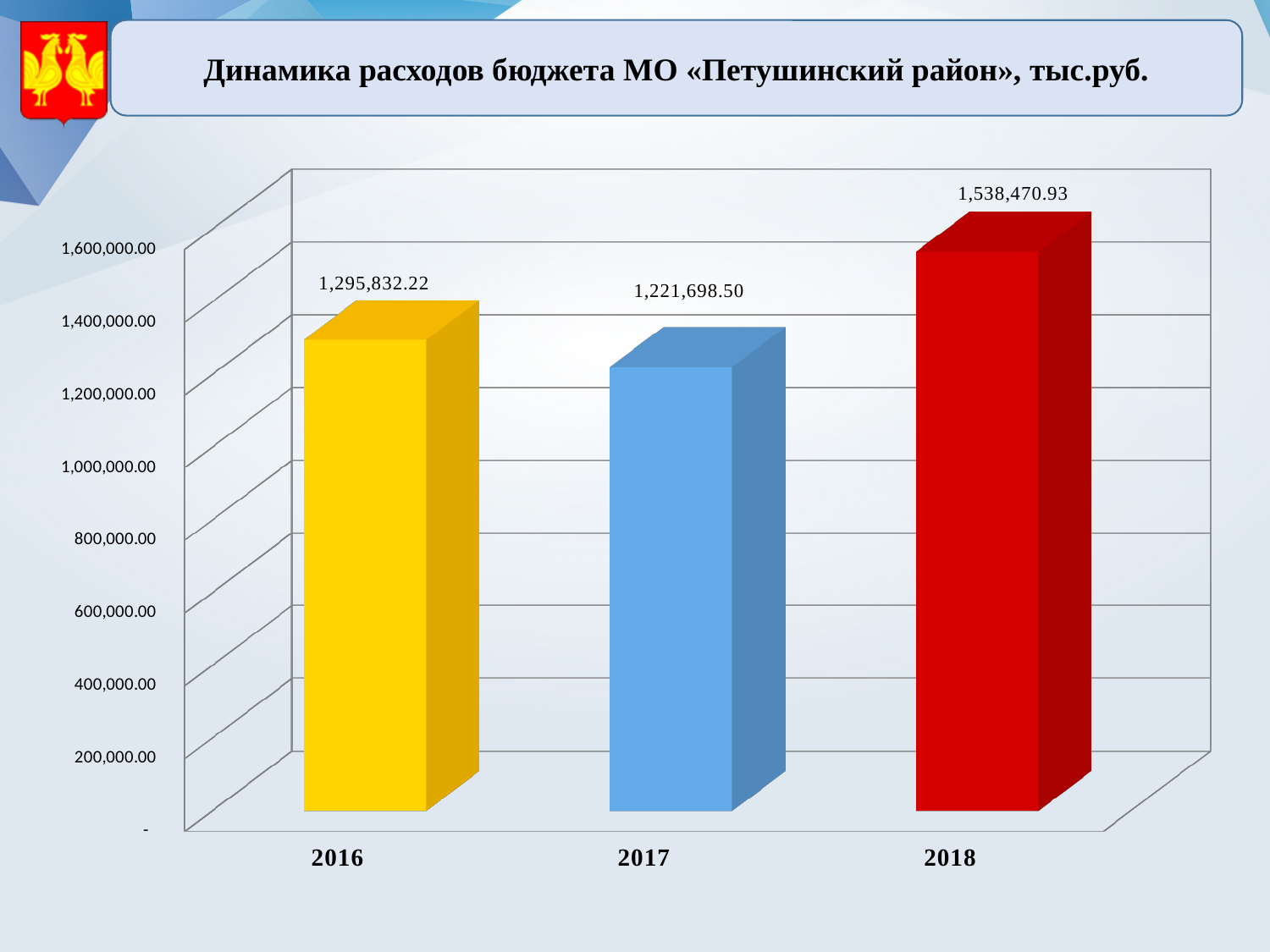
What is the difference between the values for 2016 and 2017? 74,133.72 What is the value for 2016? 1,295,832.22 What is the value for 2018? 1,538,470.93 How many years are shown on the x axis? 3 What is the value for 2017? 1,221,698.50 Is the value for 2017 greater or less than 1,400,000.00? less What is the title of the chart? Динамика расходов бюджета МО «Петушинский район», тыс.руб. Which year has the highest value? 2018 What is the difference between the values for 2018 and 2016? 242,638.71 What kind of chart is shown on the slide? bar chart Which is larger, the value for 2016 or the value for 2017? 2016 Which year has the lowest value? 2017